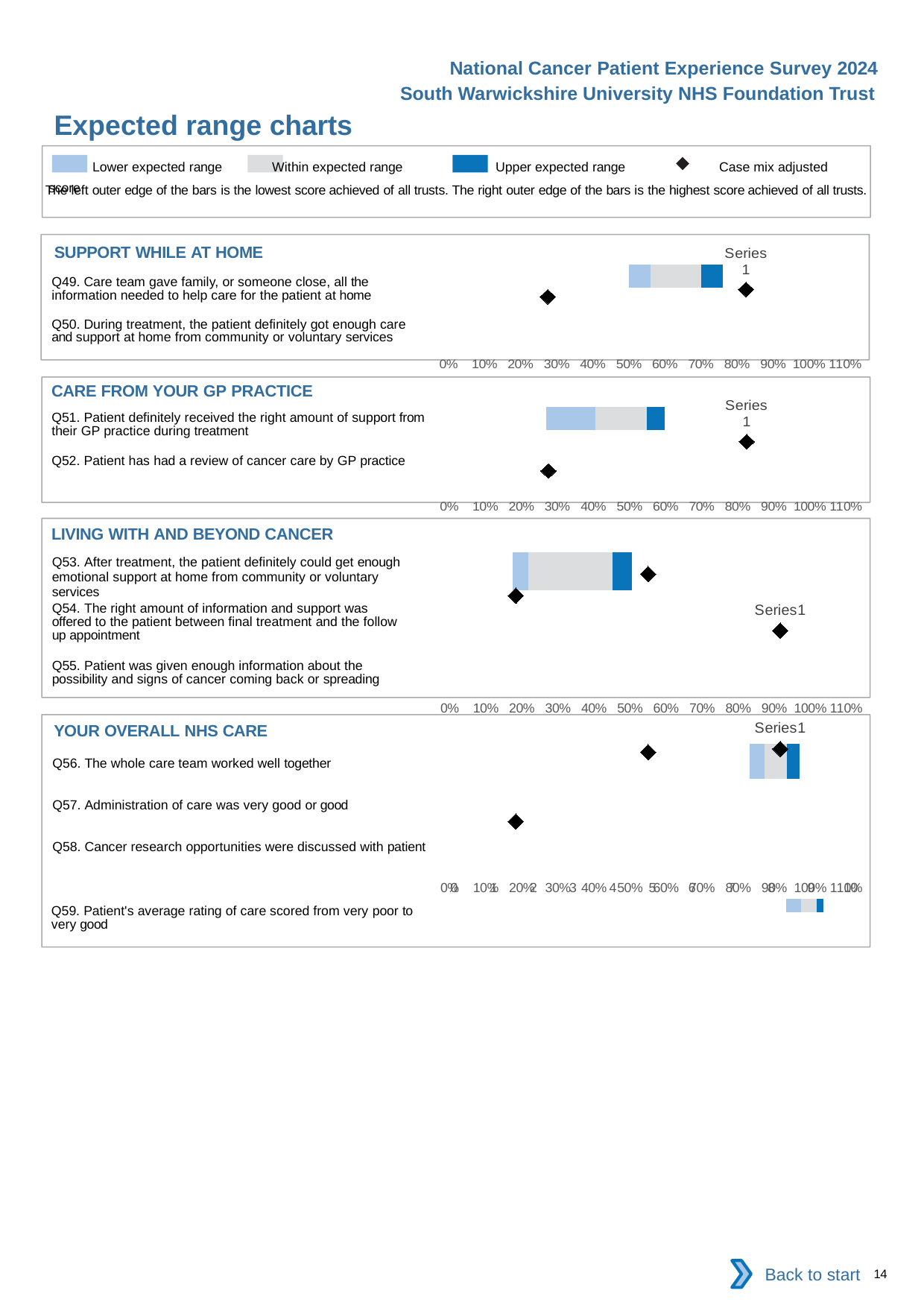
How many questions are listed in the YOUR OVERALL NHS CARE chart? 4 In the SUPPORT WHILE AT HOME chart, is the leftmost diamond marker greater or less than 40%? less What is the highest tick label on the x axis of the SUPPORT WHILE AT HOME chart? 110% In the LIVING WITH AND BEYOND CANCER chart, is the rightmost diamond marker greater or less than 80%? greater How many questions are listed in the LIVING WITH AND BEYOND CANCER chart? 3 How many entries does the legend at the top of the slide list? 4 What kind of chart is used in the SUPPORT WHILE AT HOME section? bar chart How many questions are listed in the CARE FROM YOUR GP PRACTICE chart? 2 In the CARE FROM YOUR GP PRACTICE chart, is the rightmost diamond marker greater or less than 70%? greater What does the diamond marker represent according to the legend? Case mix adjusted score